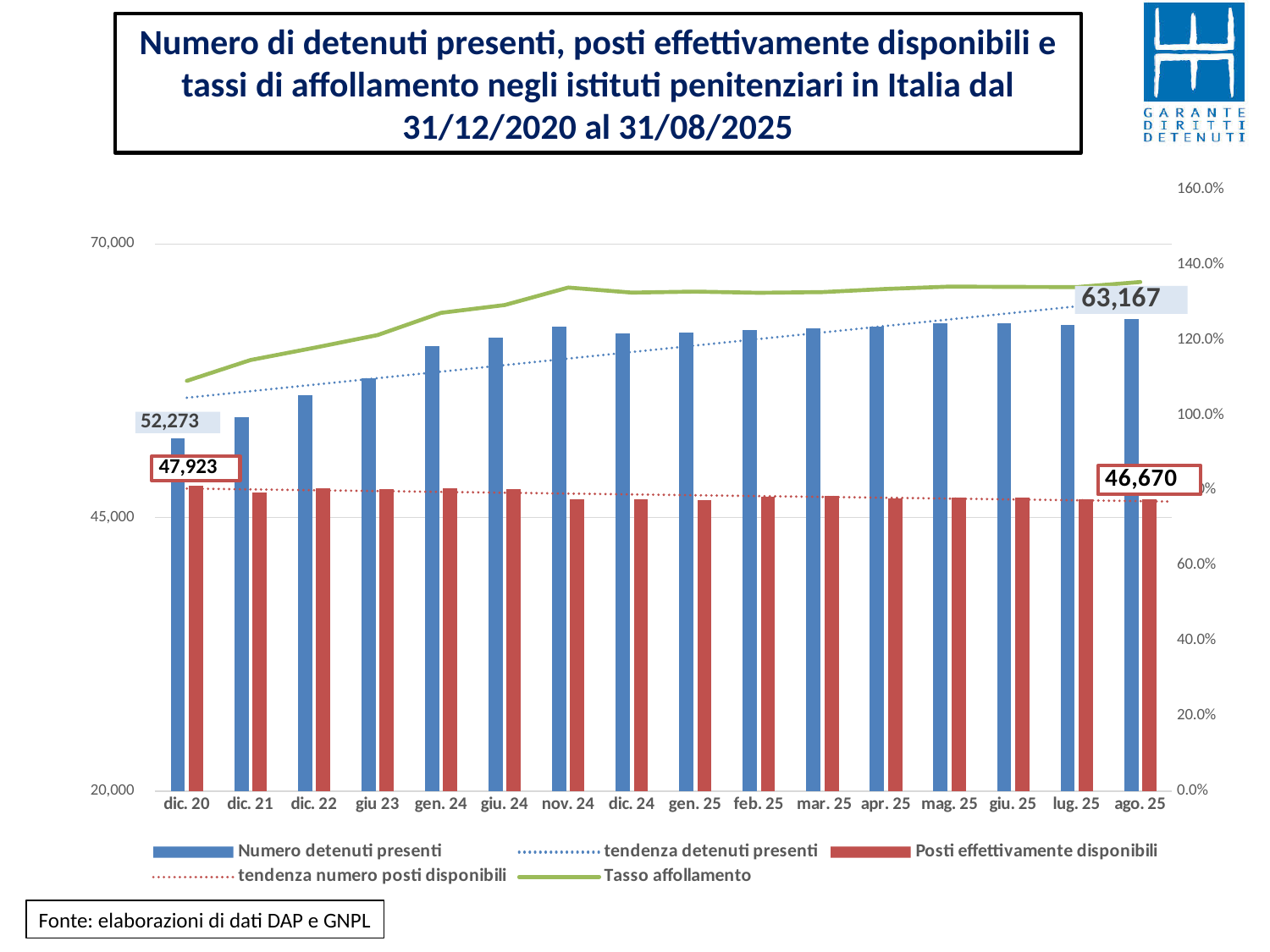
Does Numero detenuti presenti generally rise or fall from dic. 20 to ago. 25? rise How many series does the legend list? 5 Which period has the lowest Numero detenuti presenti? dic. 20 What is the value of Posti effettivamente disponibili for ago. 25? 46,670 What is the value of Numero detenuti presenti for ago. 25? 63,167 How many time periods are shown on the x axis? 16 What is the value of Posti effettivamente disponibili for dic. 20? 47,923 What is the difference between Numero detenuti presenti and Posti effettivamente disponibili in ago. 25? 16,497 Is the Tasso affollamento for ago. 25 greater or less than 120.0%? greater By how much did Numero detenuti presenti increase from dic. 20 to ago. 25? 10,894 What is the value of Numero detenuti presenti for dic. 20? 52,273 In dic. 20, which is larger: Numero detenuti presenti or Posti effettivamente disponibili? Numero detenuti presenti